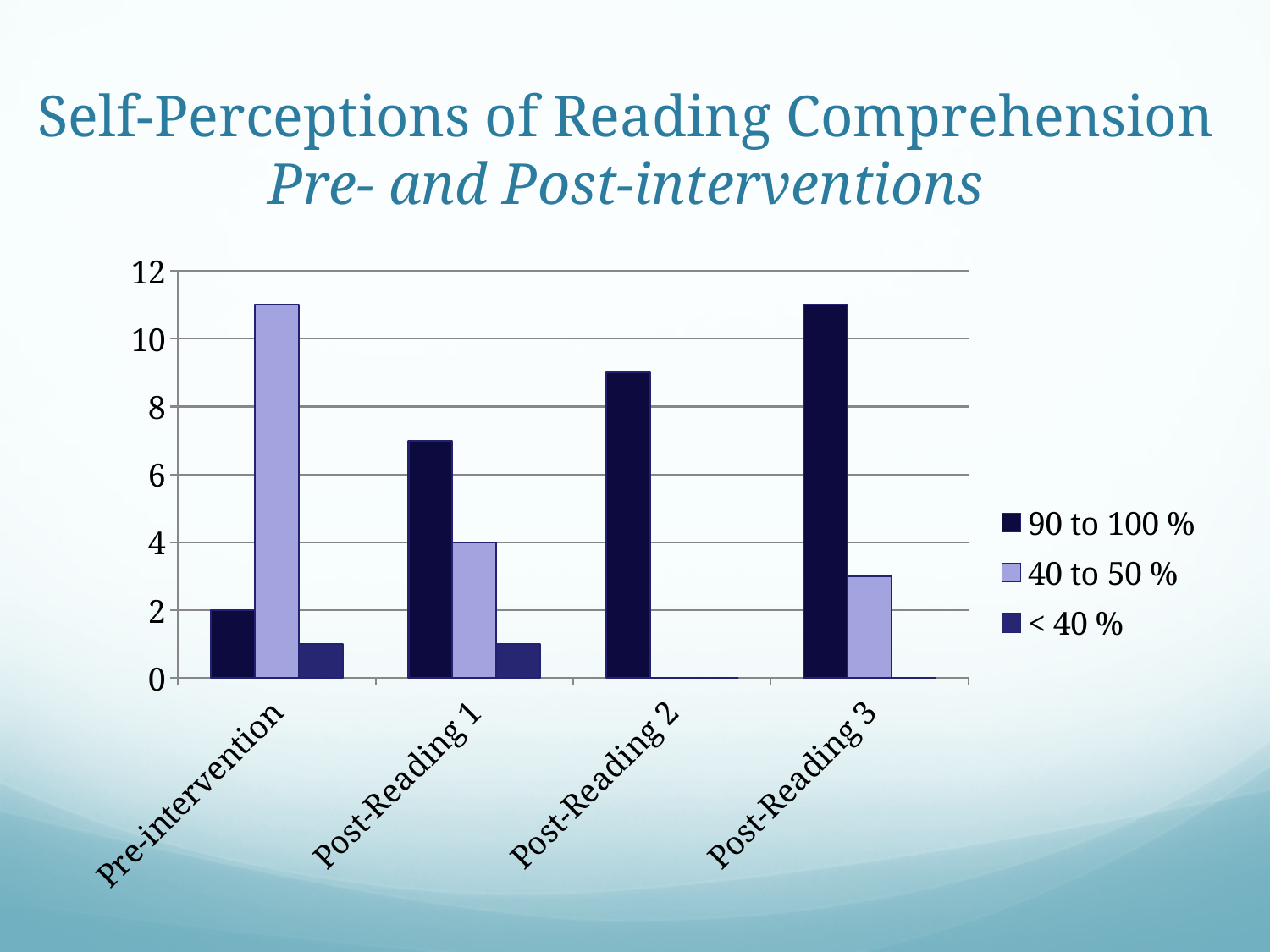
Is the value of the 90 to 100 % series for Post-Reading 2 greater or less than 8? greater Is the value of the 40 to 50 % series for Post-Reading 3 greater or less than 4? less How many categories are shown on the x axis? 4 What is the value of the 40 to 50 % series for Post-Reading 1? 4 For Post-Reading 1, which is larger: the 90 to 100 % series or the 40 to 50 % series? 90 to 100 % Does the 90 to 100 % series rise or fall from Pre-intervention to Post-Reading 3? rise How many series does the legend list? 3 Which category has the highest value for the 90 to 100 % series? Post-Reading 3 What is the value of the 90 to 100 % series for Pre-intervention? 2 Which category has the lowest value for the 90 to 100 % series? Pre-intervention What kind of chart is shown on the slide? bar chart Is the value of the 40 to 50 % series for Pre-intervention greater or less than 10? greater